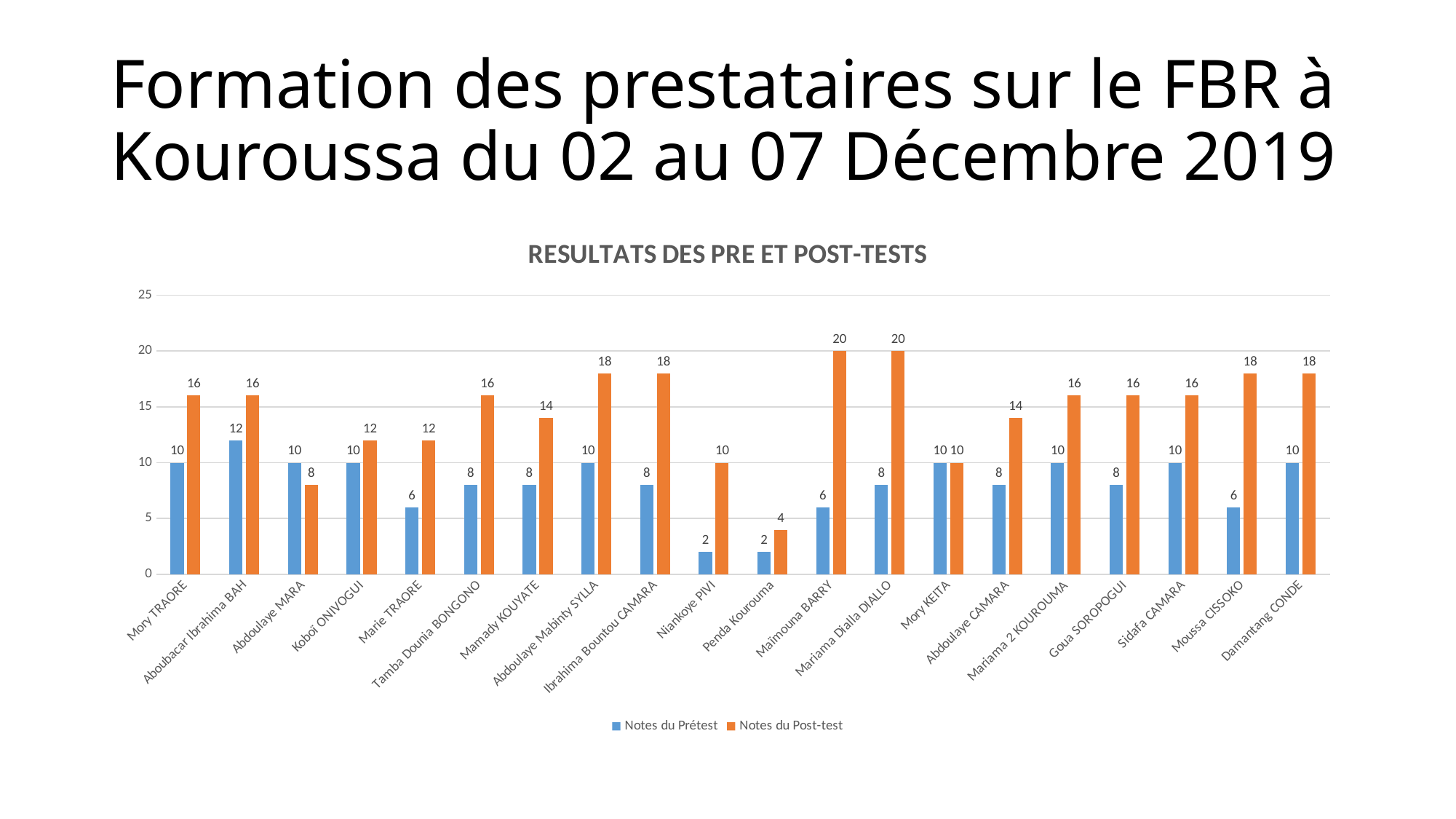
What is the Notes du Post-test value for Penda Kourouma? 4 What is the Notes du Post-test value for Maïmouna BARRY? 20 Which participant has the highest Notes du Prétest value? Aboubacar Ibrahima BAH What is the title of the chart? RESULTATS DES PRE ET POST-TESTS Which colour represents Notes du Post-test in the legend? Orange How many participants are shown on the x axis? 20 What is the Notes du Prétest value for Aboubacar Ibrahima BAH? 12 Which is larger for Abdoulaye MARA, the Notes du Prétest or the Notes du Post-test value? Notes du Prétest How many series does the legend list? 2 Which participant has the lowest Notes du Post-test value? Penda Kourouma What kind of chart is shown? Bar chart What is the difference between the Notes du Post-test and Notes du Prétest values for Maïmouna BARRY? 14